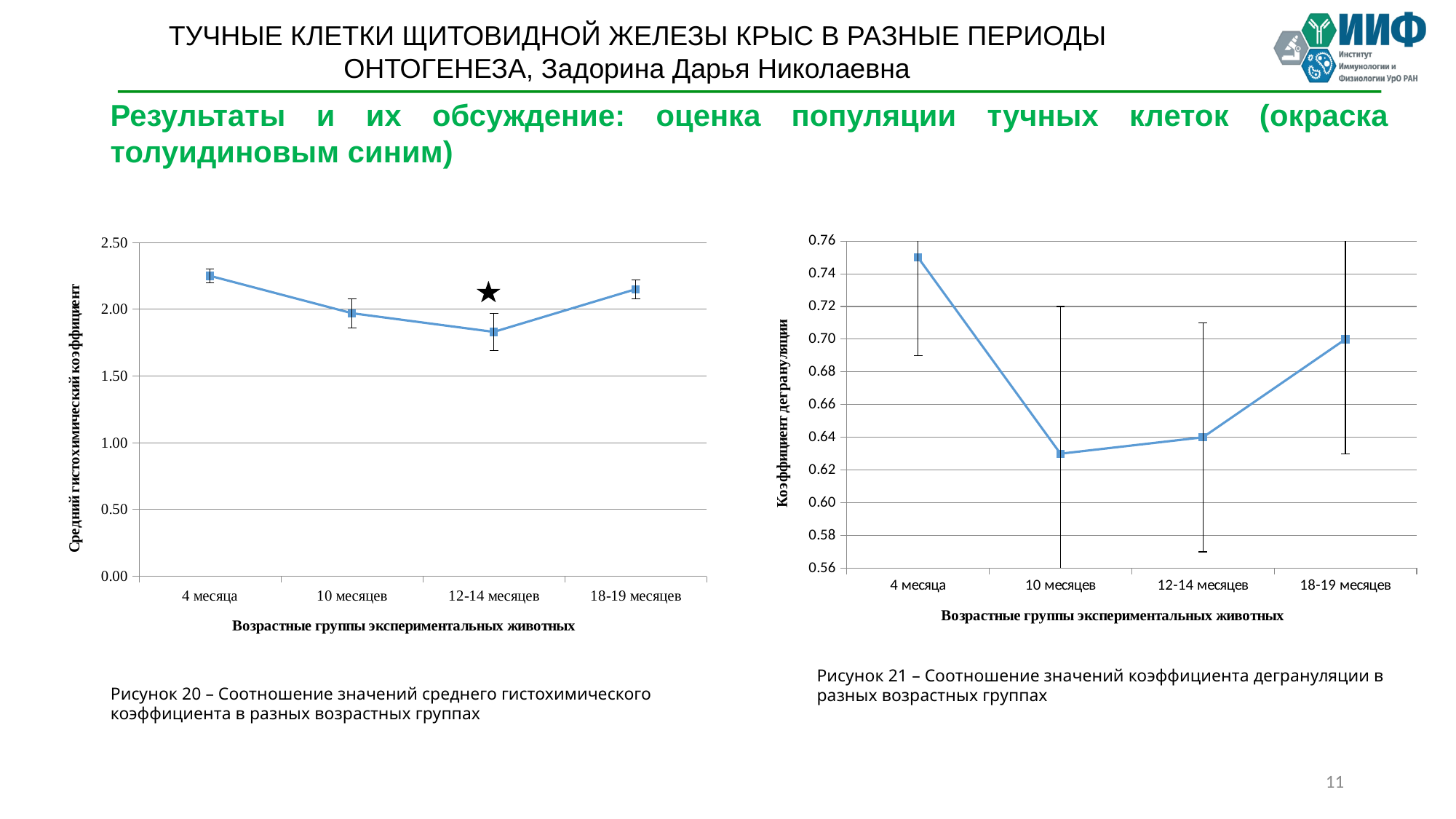
In the left chart (Рисунок 20), is the value for 4 месяца greater or less than 2.00? greater What kind of chart is the left chart (Рисунок 20)? line chart How many age groups are plotted on the x axis of the left chart (Рисунок 20)? 4 In the left chart (Рисунок 20), which age group is marked with a star symbol? 12-14 месяцев In the right chart (Рисунок 21), which age group has the lowest degranulation coefficient? 10 месяцев In the right chart (Рисунок 21), which age group has the highest degranulation coefficient? 4 месяца In the right chart (Рисунок 21), is the value for 10 месяцев greater or less than 0.66? less In the left chart (Рисунок 20), which age group has the lowest mean histochemical coefficient? 12-14 месяцев In the left chart (Рисунок 20), which age group has the highest mean histochemical coefficient? 4 месяца In the left chart (Рисунок 20), is the value for 12-14 месяцев greater or less than 2.00? less In the right chart (Рисунок 21), which is larger: the value for 4 месяца or the value for 18-19 месяцев? 4 месяца What is the y-axis title of the right chart (Рисунок 21)? Коэффициент дегрануляции